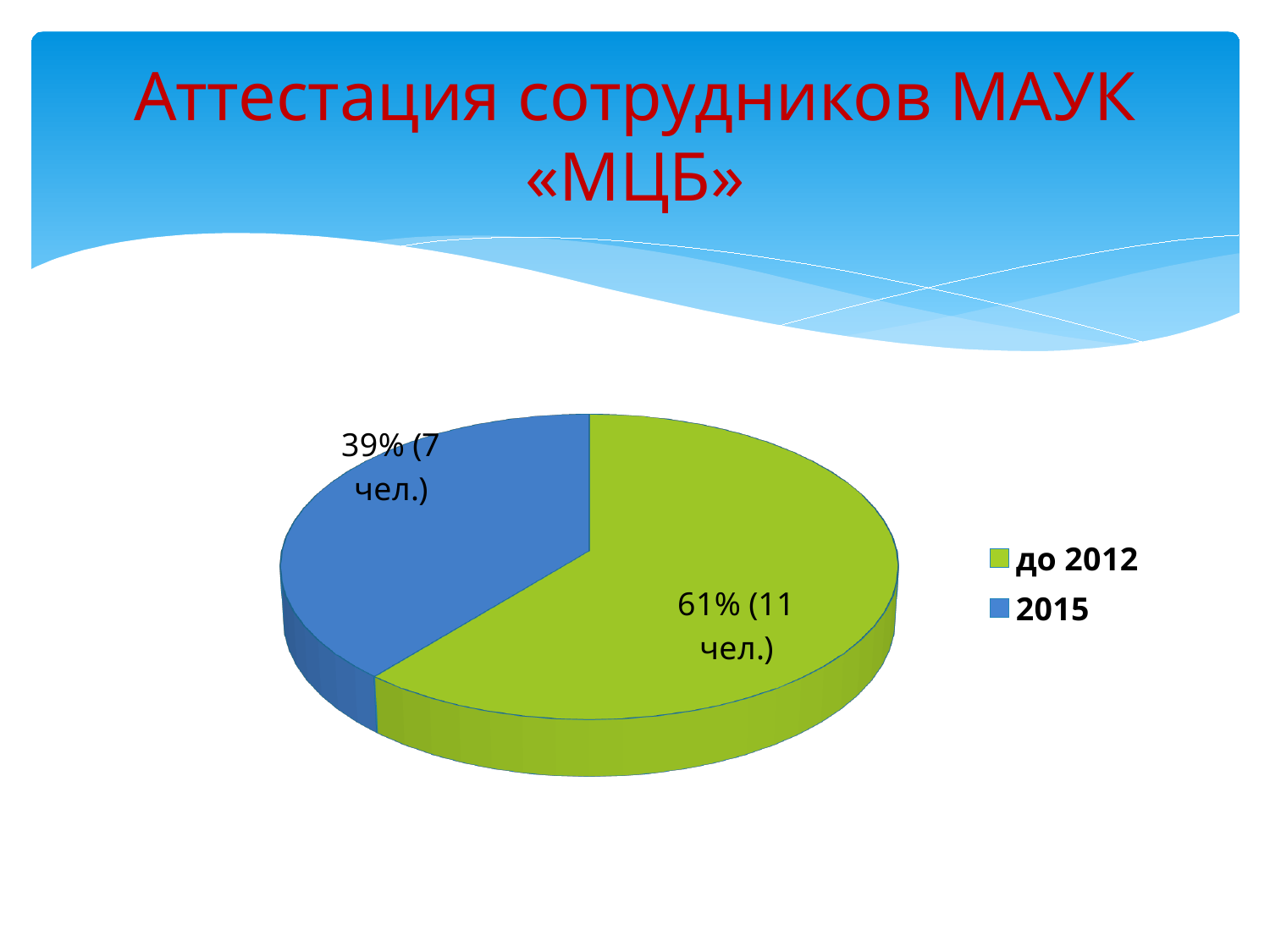
What kind of chart is shown on the slide? pie chart How many people are in the "до 2012" category? 11 чел. How many categories does the pie chart have? 2 What share of the pie does the "2015" slice represent? 39% Which is larger: the "до 2012" slice or the "2015" slice? до 2012 Which category has the largest slice of the pie? до 2012 What share of the pie does the "до 2012" slice represent? 61% What is the difference in percentage points between the "до 2012" and "2015" slices? 22 What colour is the "2015" slice? blue How many people are in the "2015" category? 7 чел. Which category has the smallest slice of the pie? 2015 How many more people are in the "до 2012" category than in the "2015" category? 4